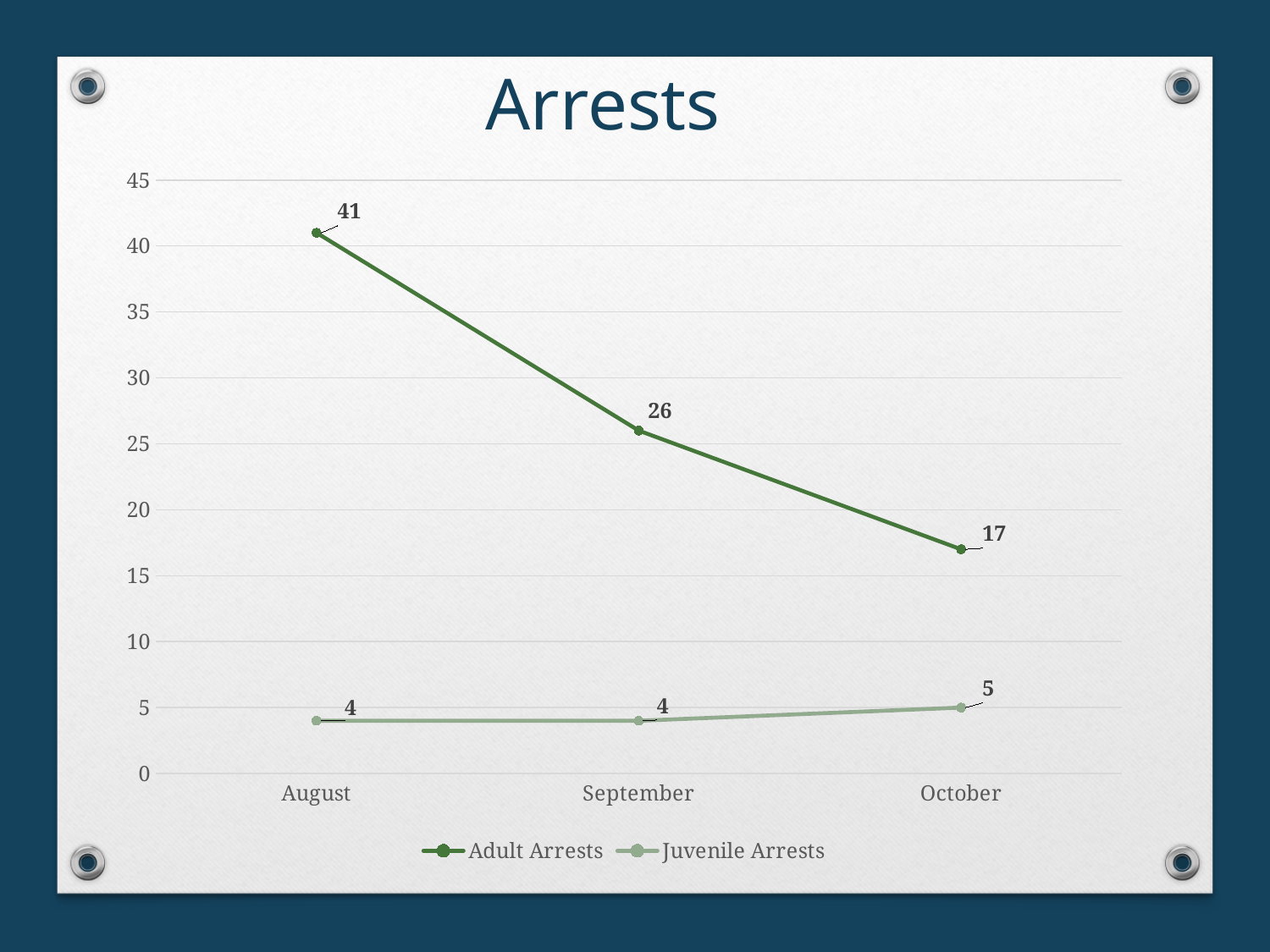
In which month are Adult Arrests highest? August What is the value for Juvenile Arrests in October? 5 How many months are shown on the x axis? 3 What is the difference between Adult Arrests and Juvenile Arrests in September? 22 How many series does the legend list? 2 Do Adult Arrests rise or fall from August to October? Fall In which month are Adult Arrests lowest? October Which is larger in October: Adult Arrests or Juvenile Arrests? Adult Arrests What is the difference between Adult Arrests in August and October? 24 What is the value for Adult Arrests in September? 26 What kind of chart is shown on the slide? Line chart What is the value for Adult Arrests in August? 41